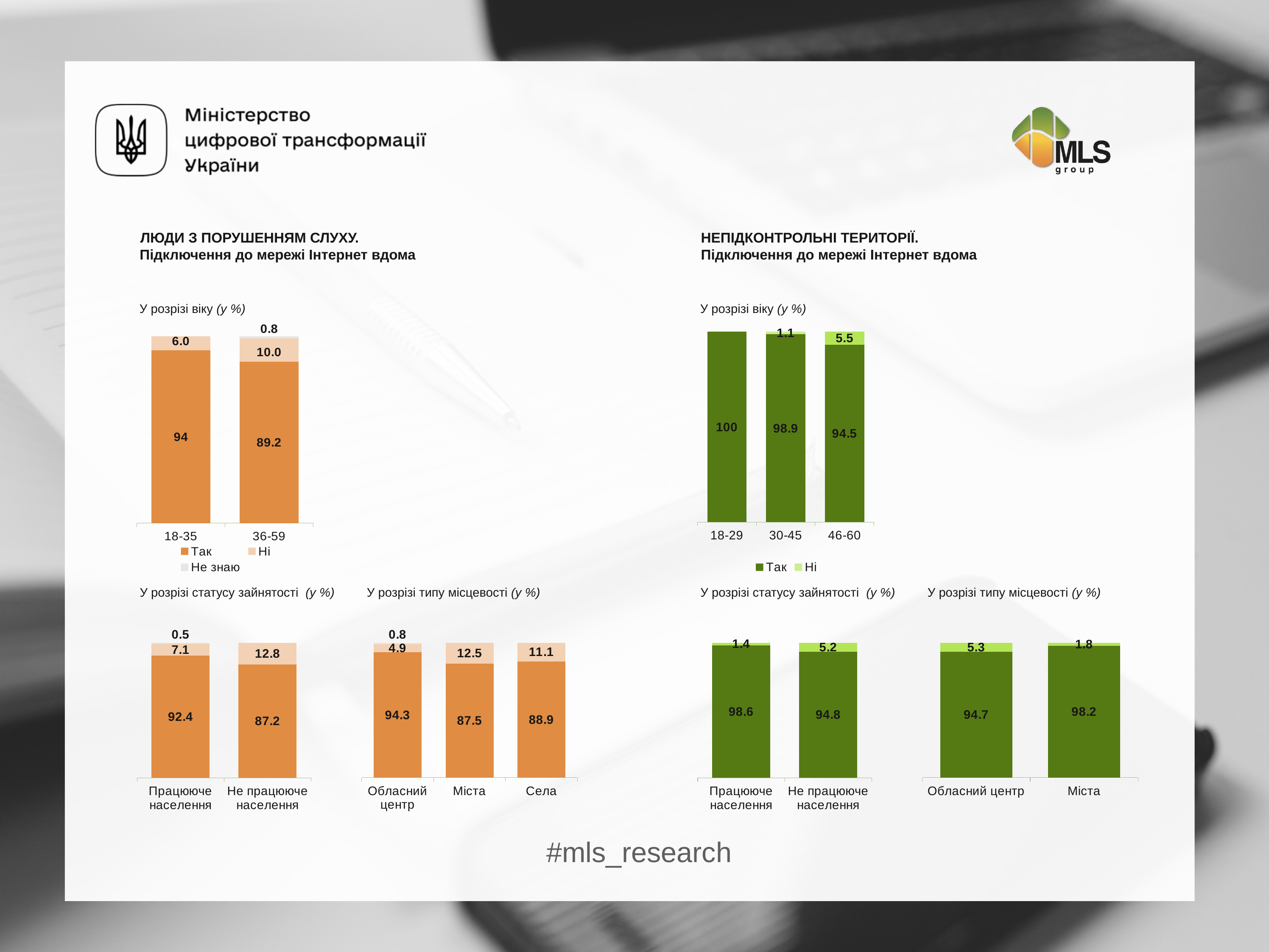
What type of chart is used for the 'НЕПІДКОНТРОЛЬНІ ТЕРИТОРІЇ' age chart ('У розрізі віку')? Stacked bar chart In the 'ЛЮДИ З ПОРУШЕННЯМ СЛУХУ' age chart ('У розрізі віку'), what is the 'Не знаю' value for the 36-59 group? 0.8 In the 'НЕПІДКОНТРОЛЬНІ ТЕРИТОРІЇ' age chart ('У розрізі віку'), which age group has the highest 'Так' value? 18-29 In the 'ЛЮДИ З ПОРУШЕННЯМ СЛУХУ' age chart ('У розрізі віку'), what is the 'Так' value for the 18-35 group? 94 In the 'НЕПІДКОНТРОЛЬНІ ТЕРИТОРІЇ' locality type chart ('У розрізі типу місцевості'), which has the larger 'Так' value: 'Обласний центр' or 'Міста'? Міста In the 'НЕПІДКОНТРОЛЬНІ ТЕРИТОРІЇ' age chart ('У розрізі віку'), what is the 'Ні' value for the 46-60 group? 5.5 In the 'НЕПІДКОНТРОЛЬНІ ТЕРИТОРІЇ' age chart ('У розрізі віку'), how many age groups are shown? 3 In the 'НЕПІДКОНТРОЛЬНІ ТЕРИТОРІЇ' employment status chart ('У розрізі статусу зайнятості'), what is the 'Ні' value for 'Не працююче населення'? 5.2 How many series does the legend of the 'ЛЮДИ З ПОРУШЕННЯМ СЛУХУ' age chart list? 3 In the 'ЛЮДИ З ПОРУШЕННЯМ СЛУХУ' employment status chart ('У розрізі статусу зайнятості'), what is the difference between the 'Так' values for 'Працююче населення' and 'Не працююче населення'? 5.2 In the 'ЛЮДИ З ПОРУШЕННЯМ СЛУХУ' locality type chart ('У розрізі типу місцевості'), which category has the lowest 'Так' value? Міста In the 'ЛЮДИ З ПОРУШЕННЯМ СЛУХУ' locality type chart ('У розрізі типу місцевості'), what is the 'Ні' value for 'Села'? 11.1